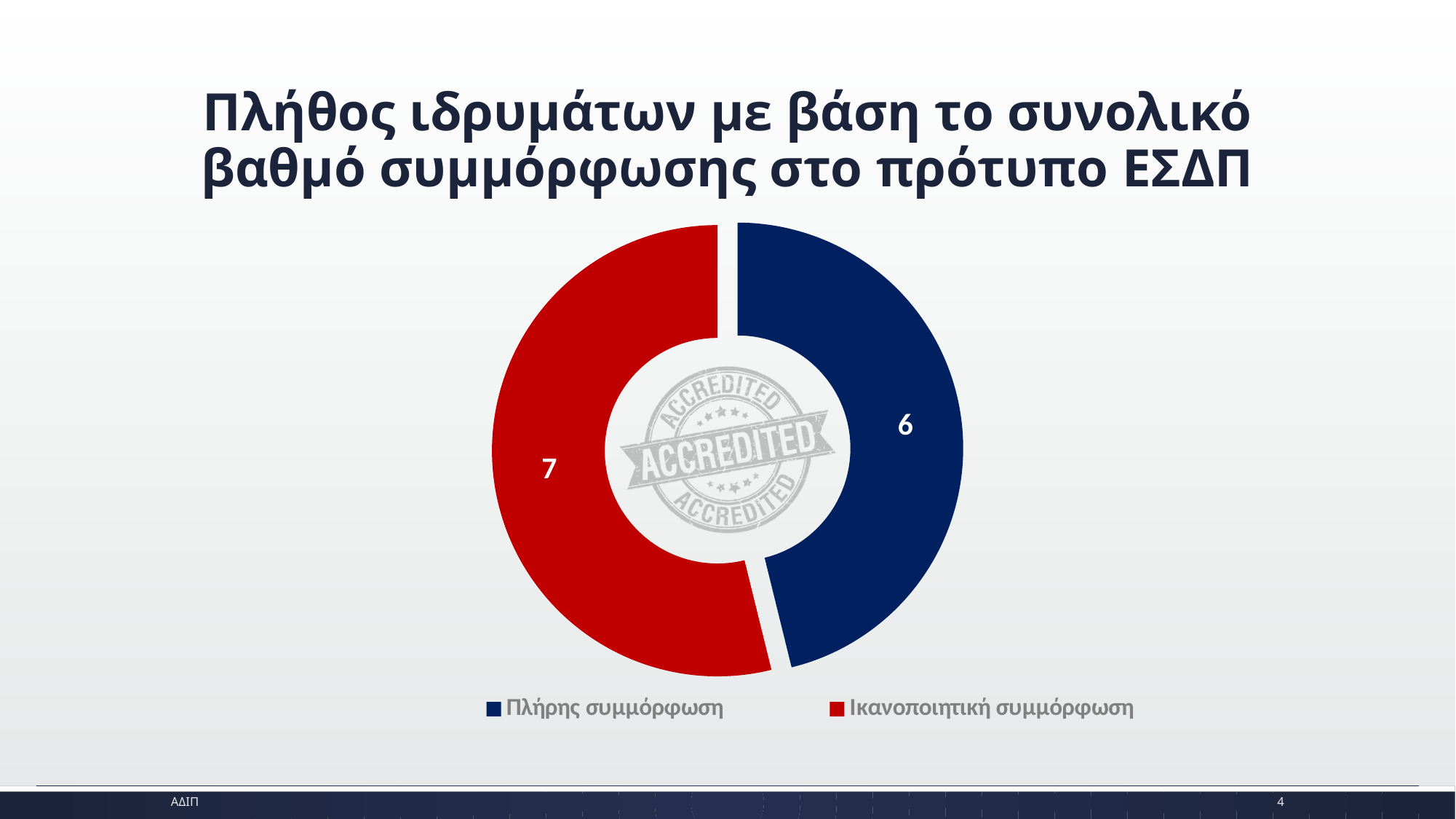
What is the value for Πλήρης συμμόρφωση? 6 How many categories are shown in the chart? 2 Which category has the highest value? Ικανοποιητική συμμόρφωση What is the difference between the values for Ικανοποιητική συμμόρφωση and Πλήρης συμμόρφωση? 1 What is the title of the chart? Πλήθος ιδρυμάτων με βάση το συνολικό βαθμό συμμόρφωσης στο πρότυπο ΕΣΔΠ What is the value for Ικανοποιητική συμμόρφωση? 7 What is the total of all the values in the chart? 13 What share of the total does Πλήρης συμμόρφωση represent? 6 out of 13 What colour is the slice for Ικανοποιητική συμμόρφωση? Red What kind of chart is shown on the slide? Doughnut chart Which category has the lowest value? Πλήρης συμμόρφωση Which is larger, the value for Πλήρης συμμόρφωση or the value for Ικανοποιητική συμμόρφωση? Ικανοποιητική συμμόρφωση